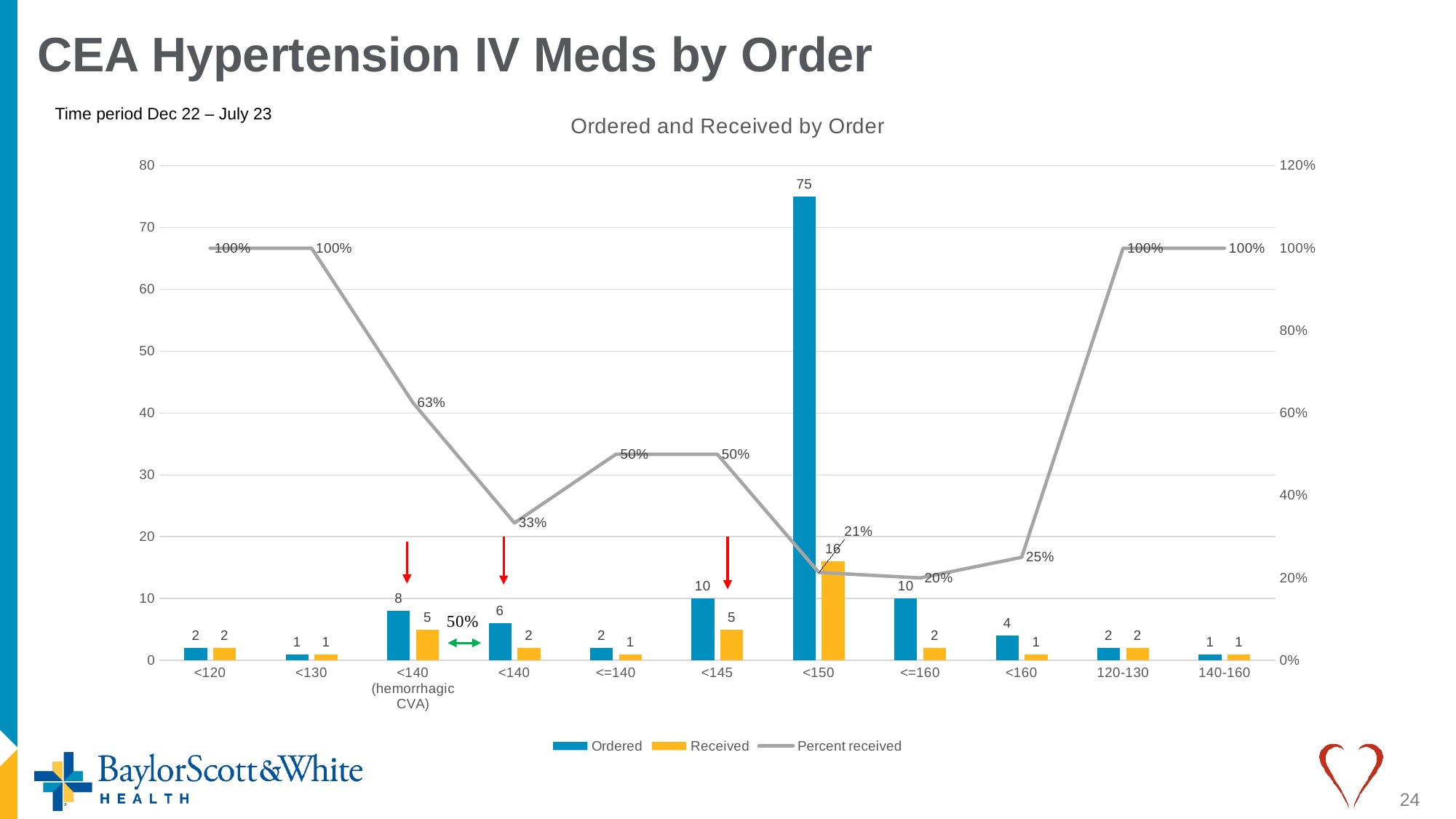
What is the Ordered value for the <140 (hemorrhagic CVA) category? 8 What is the Received value for the <150 category? 16 How many series does the legend list? 3 What is the Percent received value for the <140 category? 33% What is the Ordered value for the <150 category? 75 What is the title of the chart? Ordered and Received by Order What is the difference between the Ordered and Received values for the <145 category? 5 Which category has the lowest Percent received value? <=160 Which category has the highest Ordered value? <150 Which is larger, the Ordered value for <=160 or the Ordered value for <160? <=160 How many categories are shown on the x axis? 11 What kind of chart is this? Combined bar and line chart